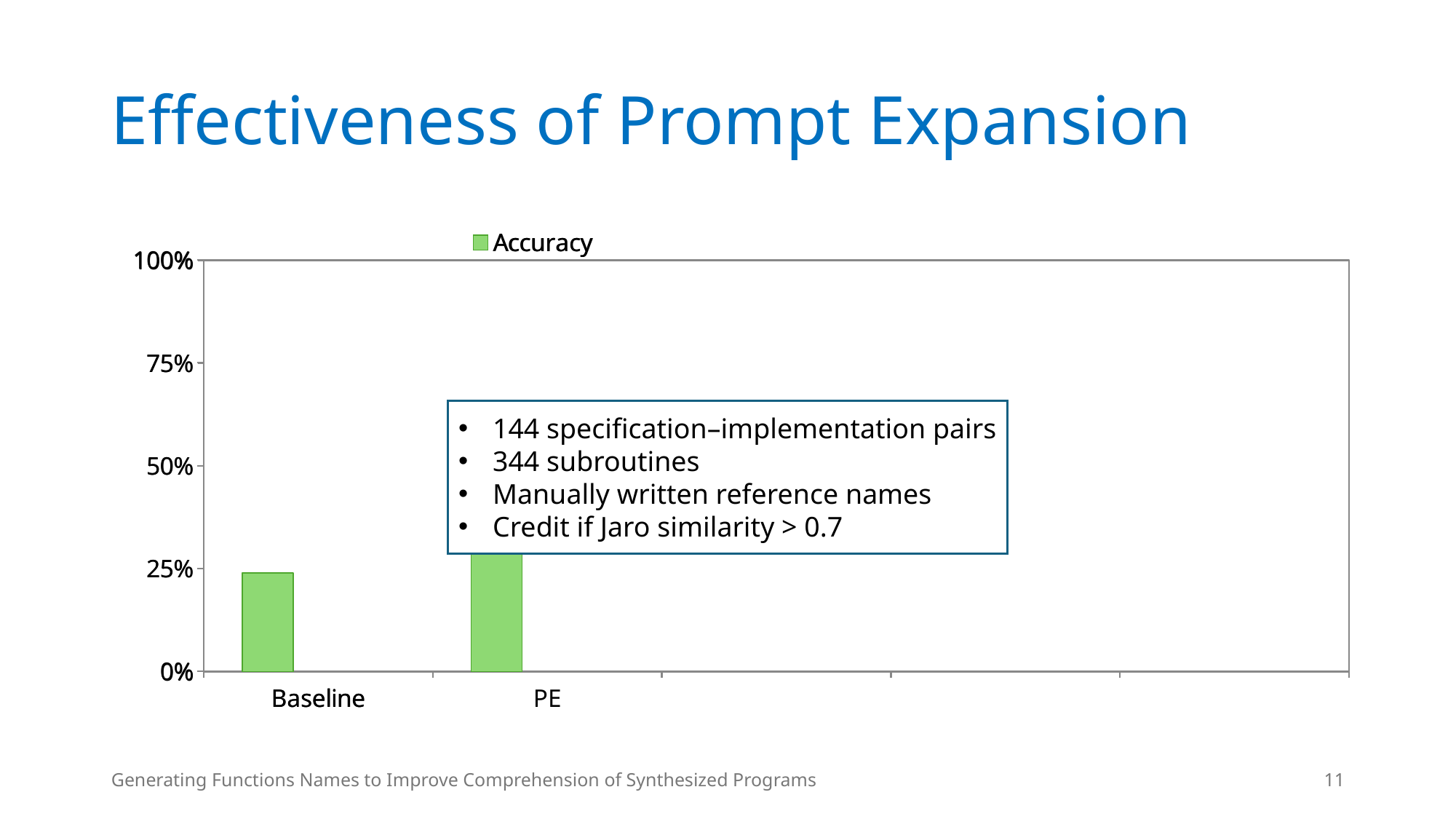
What is the highest value shown on the y axis of the chart? 100% What kind of chart is shown on the slide? bar chart What is the title of the slide containing the chart? Effectiveness of Prompt Expansion Which category has the highest Accuracy bar? PE Is the Accuracy value for PE greater or less than 25%? greater Which category has the higher Accuracy bar, Baseline or PE? PE What is the name of the series shown in the chart legend? Accuracy How many labeled categories are shown on the x axis of the chart? 2 Does the Accuracy value rise or fall from Baseline to PE? rise Is the Accuracy value for Baseline greater or less than 50%? less Which category has the lowest Accuracy bar? Baseline How many series does the chart legend list? 1